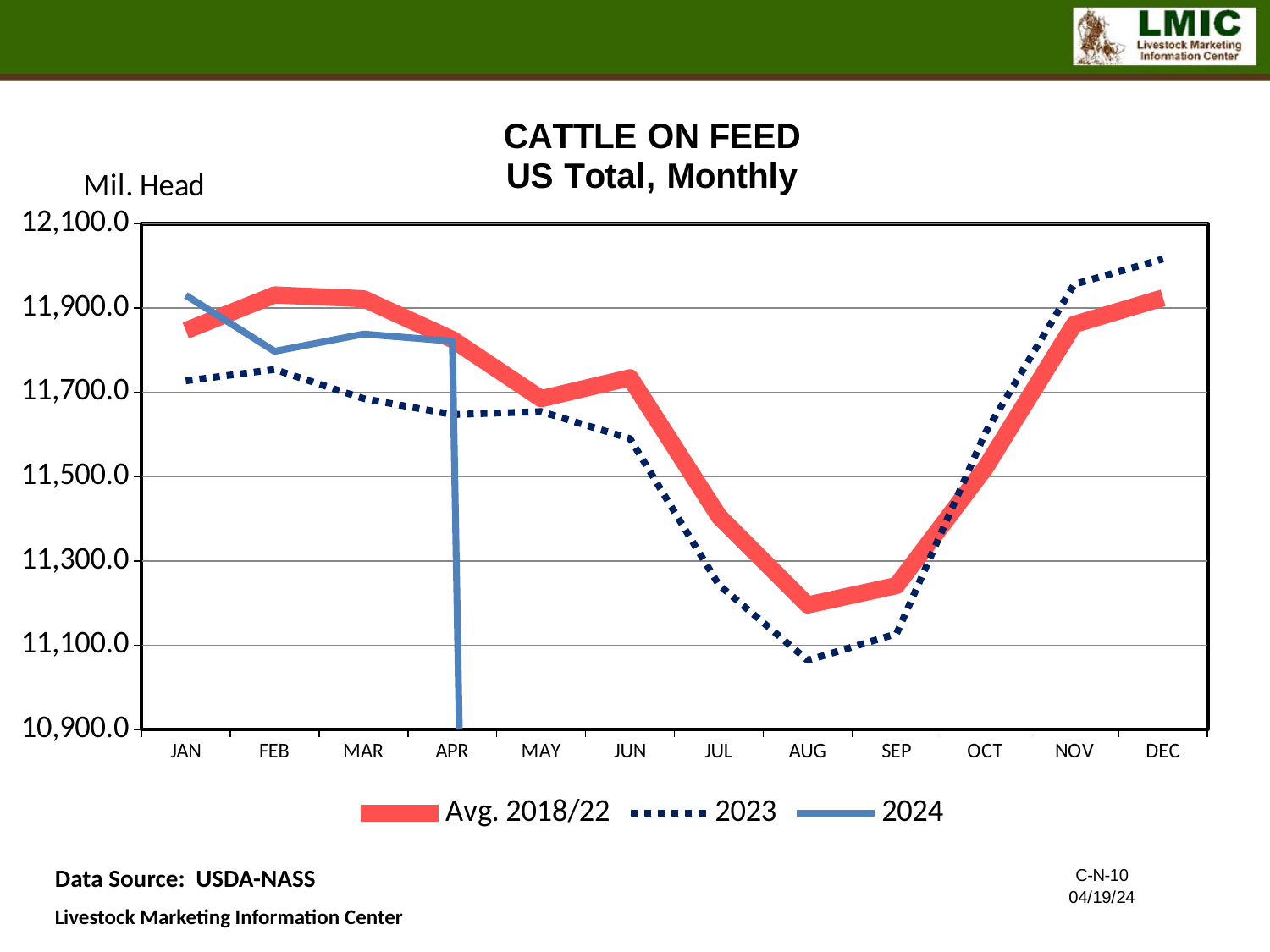
Does the Avg. 2018/22 series rise or fall from JUN to AUG? fall How many series does the legend list? 3 In which month is the Avg. 2018/22 series at its lowest? AUG Is the 2023 value for DEC greater or less than 11,900.0? greater In which month is the 2023 series at its highest? DEC In JAN, which series is higher: 2024 or 2023? 2024 In DEC, which series is higher: 2023 or Avg. 2018/22? 2023 In which month is the 2023 series at its lowest? AUG Is the 2023 value for AUG greater or less than 11,100.0? less Is the 2024 value for FEB greater or less than 11,700.0? greater How many months are shown along the x axis? 12 What kind of chart is shown on the slide? line chart